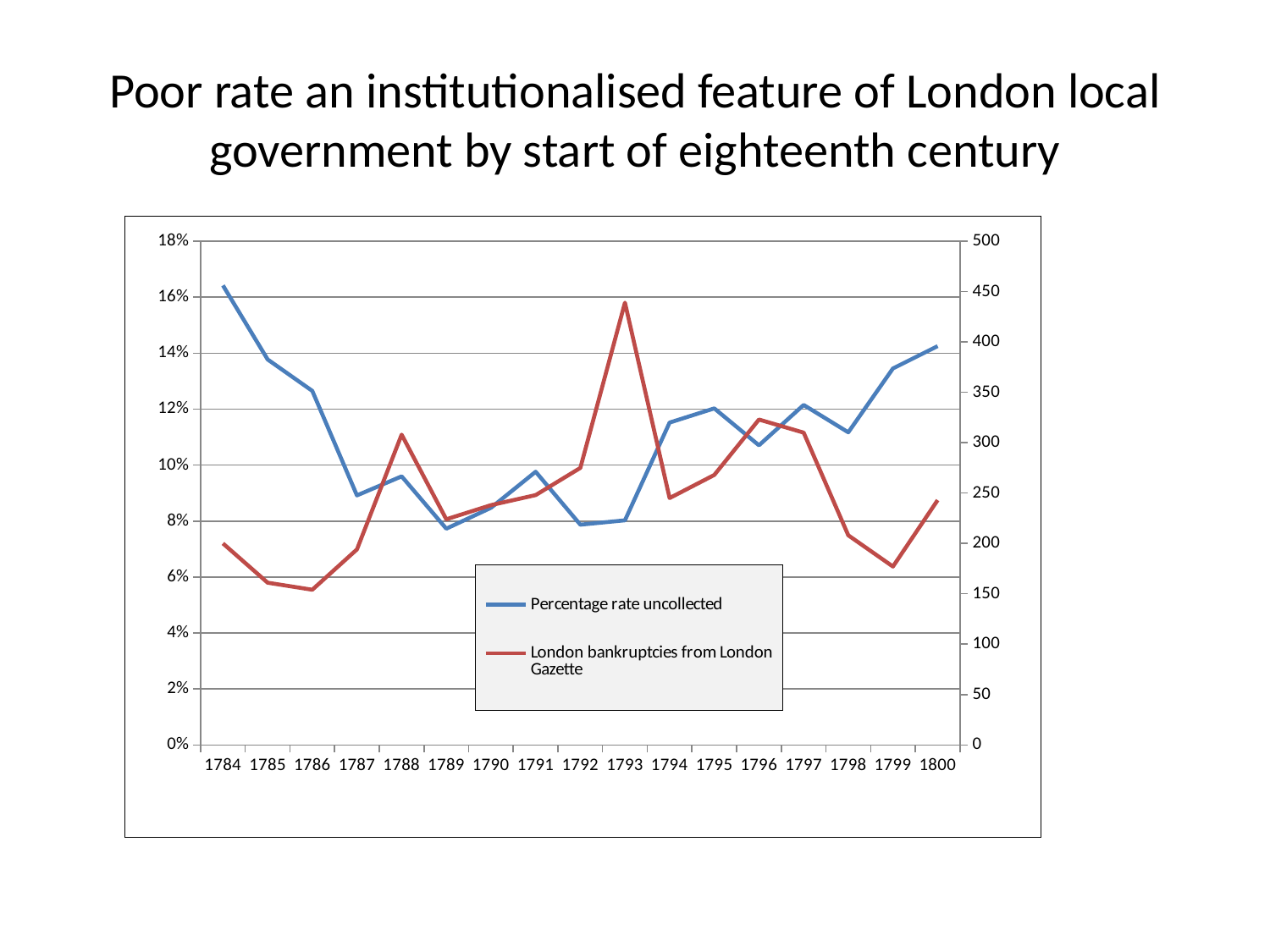
Is the Percentage rate uncollected in 1789 greater or less than 10%? less Is the Percentage rate uncollected in 1784 greater or less than 14%? greater What kind of chart is shown on the slide? line chart In which year are London bankruptcies from London Gazette highest? 1793 How many series does the legend list? 2 Is the value for London bankruptcies from London Gazette in 1793 greater or less than 400? greater Do London bankruptcies from London Gazette rise or fall from 1797 to 1799? fall In which year is the Percentage rate uncollected highest? 1784 Which colour is used for the London bankruptcies from London Gazette line? red Does the Percentage rate uncollected rise or fall from 1784 to 1787? fall How many years are plotted along the x axis? 17